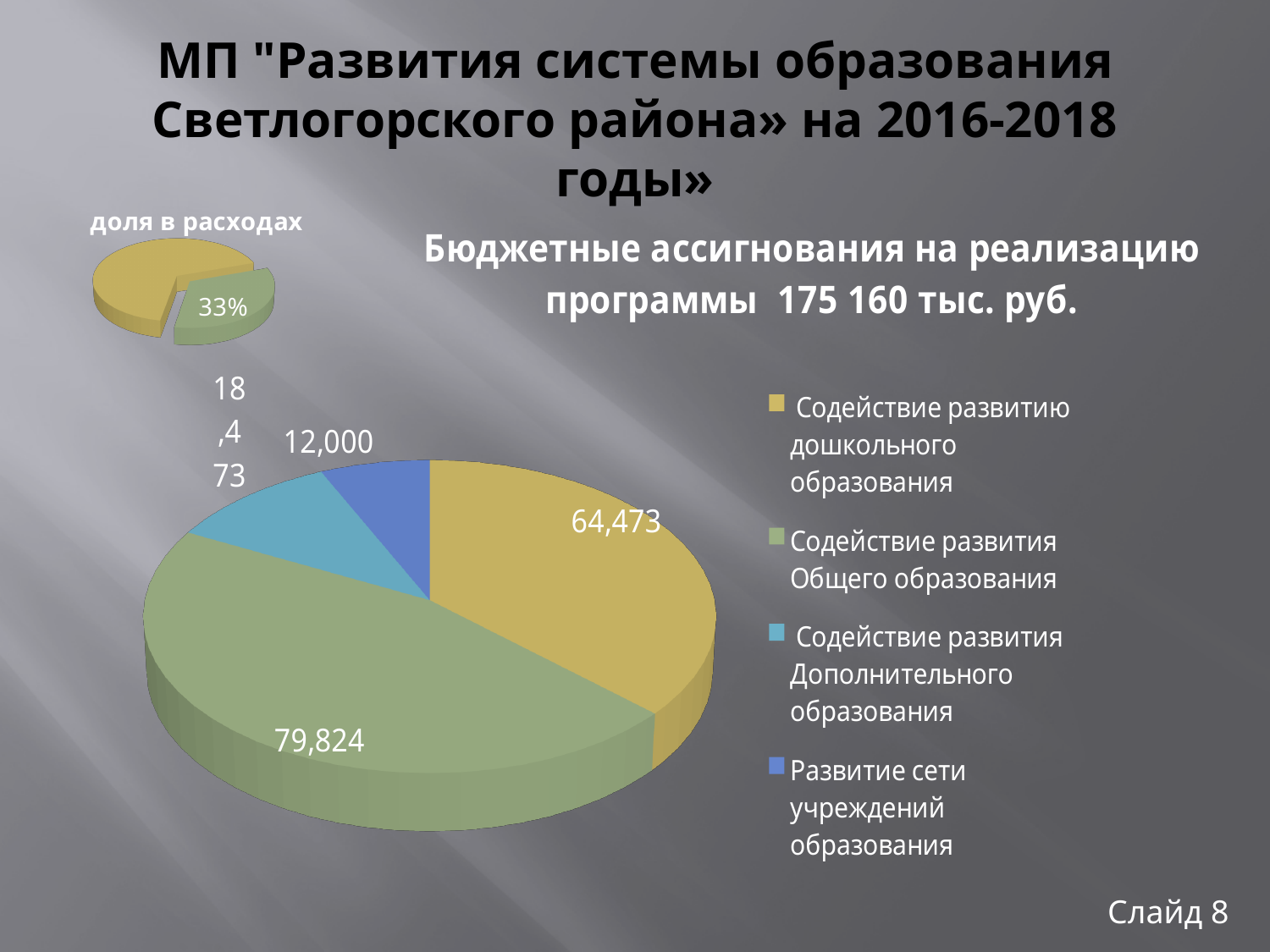
On the large pie chart, what is the difference between the values for Содействие развития Дополнительного образования and Развитие сети учреждений образования? 6,473 How many categories does the large pie chart show? 4 On the large pie chart, which category has the smallest value? Развитие сети учреждений образования What type of chart is the large chart on the slide? Pie chart On the large pie chart, what is the value for Содействие развития Общего образования? 79,824 What is the title of the small pie chart in the upper left of the slide? доля в расходах On the large pie chart, what is the value for Содействие развитию дошкольного образования? 64,473 On the large pie chart, which is larger: Содействие развитию дошкольного образования or Содействие развития Дополнительного образования? Содействие развитию дошкольного образования On the large pie chart, which category has the largest value? Содействие развития Общего образования On the large pie chart, what is the value for Развитие сети учреждений образования? 12,000 On the large pie chart, what is the value for Содействие развития Дополнительного образования? 18,473 On the large pie chart, what is the difference between the values for Содействие развития Общего образования and Содействие развитию дошкольного образования? 15,351